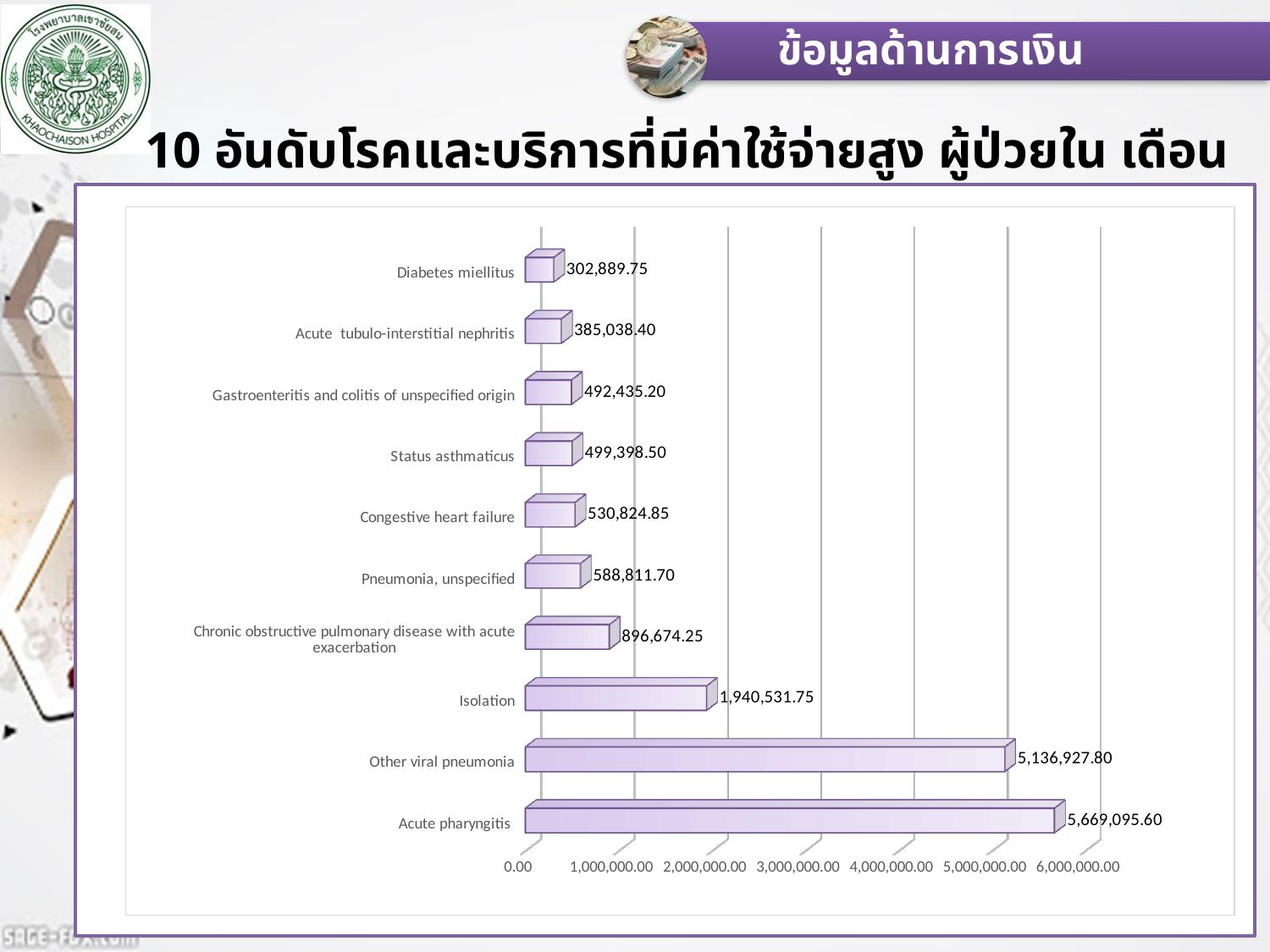
Is the value for Isolation greater or less than 1,000,000.00? greater Which category has the lowest value? Diabetes miellitus Which is larger, the value for Pneumonia, unspecified or the value for Congestive heart failure? Pneumonia, unspecified Which category has the highest value? Acute pharyngitis What kind of chart is shown on the slide? bar chart What is the difference between the values for Acute pharyngitis and Other viral pneumonia? 532,167.80 What is the value for Chronic obstructive pulmonary disease with acute exacerbation? 896,674.25 What is the value for Isolation? 1,940,531.75 What is the difference between the values for Isolation and Chronic obstructive pulmonary disease with acute exacerbation? 1,043,857.50 How many categories are shown in the chart? 10 What is the value for Acute pharyngitis? 5,669,095.60 What is the value for Congestive heart failure? 530,824.85